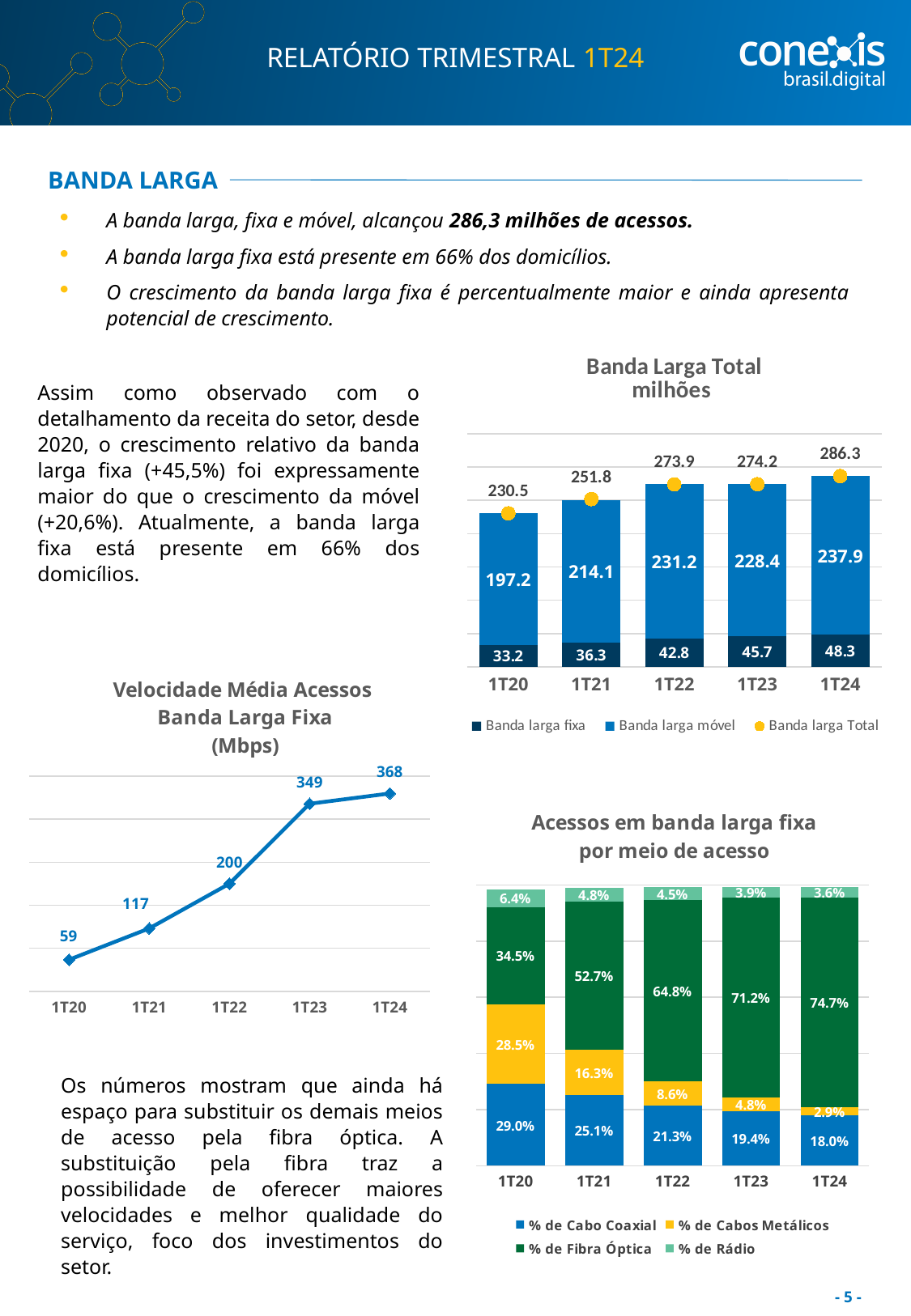
In the 'Banda Larga Total' chart, what is the value for Banda larga fixa in 1T24? 48.3 In the 'Velocidade Média Acessos Banda Larga Fixa' chart, what is the value for 1T22? 200 In the 'Acessos em banda larga fixa por meio de acesso' chart, which quarter has the highest % de Cabo Coaxial? 1T20 In the 'Banda Larga Total' chart, what is the Banda larga Total value for 1T22? 273.9 What kind of chart is 'Velocidade Média Acessos Banda Larga Fixa (Mbps)'? line chart In the 'Velocidade Média Acessos Banda Larga Fixa' chart, do the values rise or fall from 1T20 to 1T24? rise In the 'Acessos em banda larga fixa por meio de acesso' chart, what is the share of % de Fibra Óptica in 1T23? 71.2% How many series does the legend of the 'Banda Larga Total' chart list? 3 In the 'Banda Larga Total' chart, what is the difference between the Banda larga móvel values for 1T24 and 1T20? 40.7 How many quarters are shown on the x axis of the 'Acessos em banda larga fixa por meio de acesso' chart? 5 In the 'Banda Larga Total' chart, which quarter has the lowest Banda larga Total value? 1T20 In the 'Velocidade Média Acessos Banda Larga Fixa' chart, what is the difference between the 1T24 and 1T23 values? 19